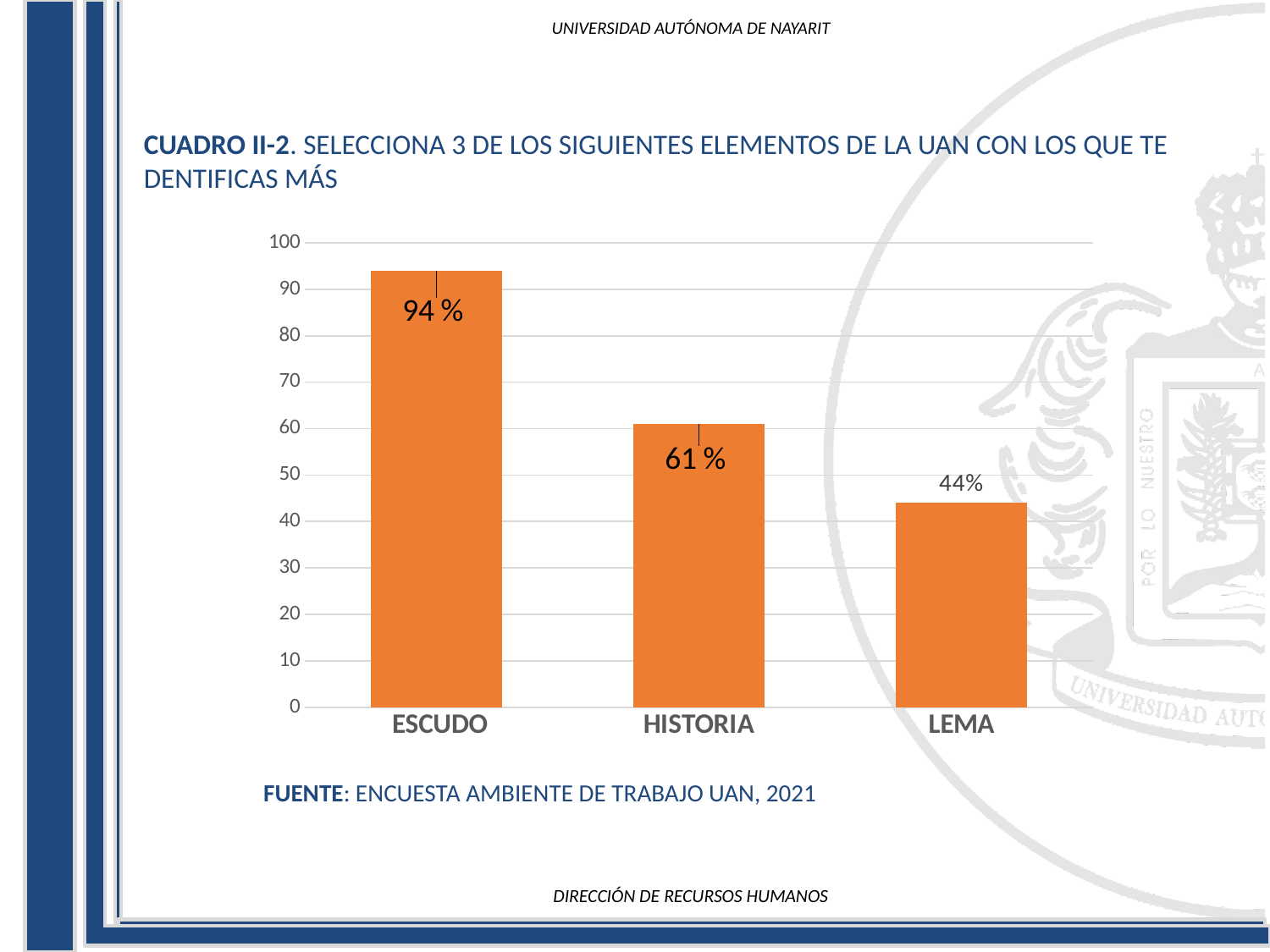
How many categories are shown on the x axis? 3 What is the difference between the values for HISTORIA and LEMA? 17 What is the difference between the values for ESCUDO and HISTORIA? 33 What kind of chart is shown on the slide? bar chart What is the value for LEMA? 44% Which category has the highest value? ESCUDO Which category has the lowest value? LEMA Is the value for LEMA greater or less than 50? less Do the values rise or fall from left to right along the x axis? fall Which is larger, the value for HISTORIA or the value for LEMA? HISTORIA What is the value for HISTORIA? 61 % What is the value for ESCUDO? 94 %